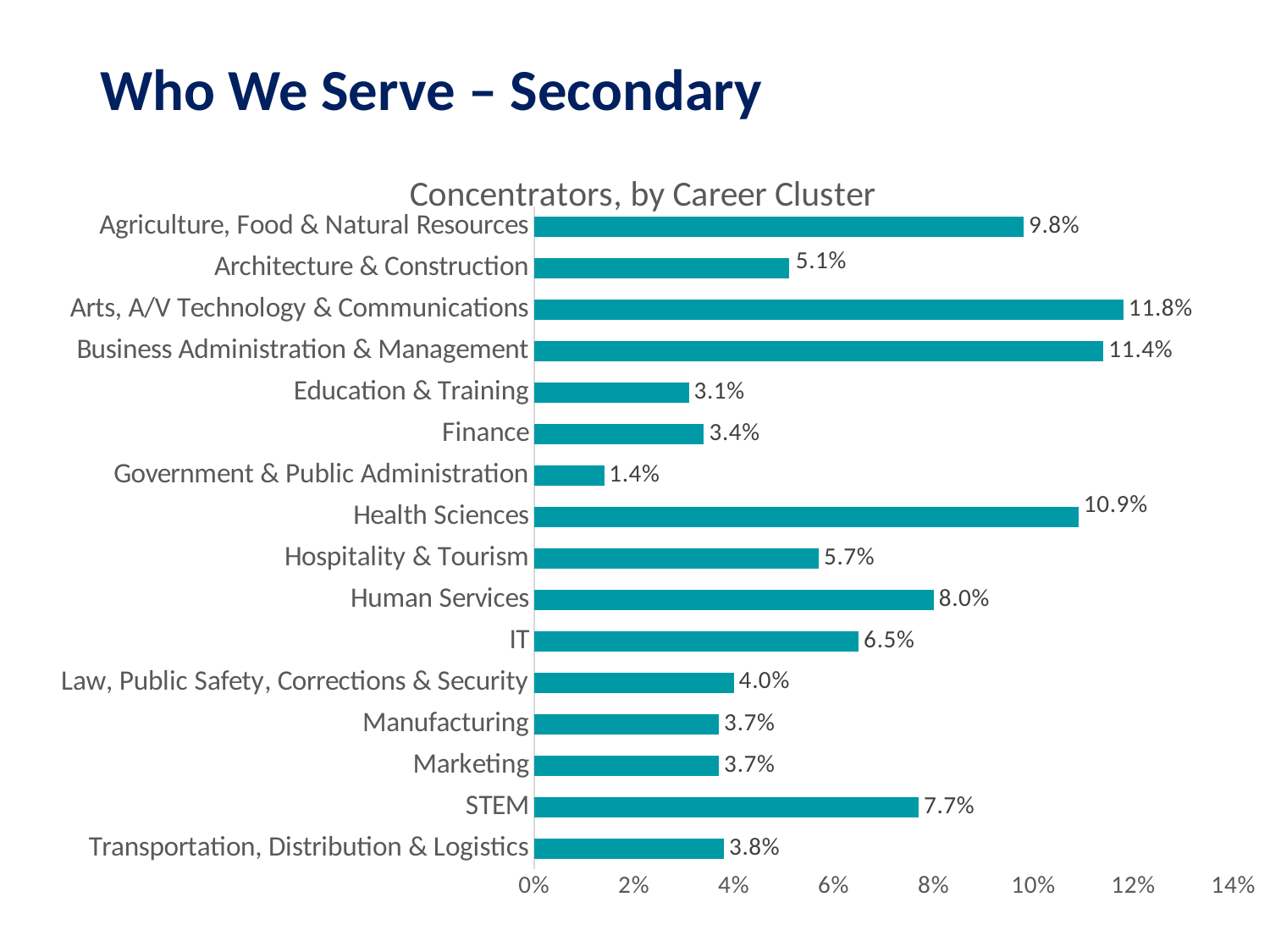
What is the difference between the values for Arts, A/V Technology & Communications and Business Administration & Management? 0.4% What is the value for STEM? 7.7% What is the value for Health Sciences? 10.9% What is the value for Government & Public Administration? 1.4% Which career cluster has the lowest share of concentrators? Government & Public Administration Which is larger, the value for Agriculture, Food & Natural Resources or the value for Health Sciences? Health Sciences What is the difference between the values for Human Services and IT? 1.5% How many career clusters are shown in the chart? 16 Which career cluster has the highest share of concentrators? Arts, A/V Technology & Communications What kind of chart is shown on the slide? Bar chart Is the value for Hospitality & Tourism greater or less than 4%? greater What is the title of the chart? Concentrators, by Career Cluster